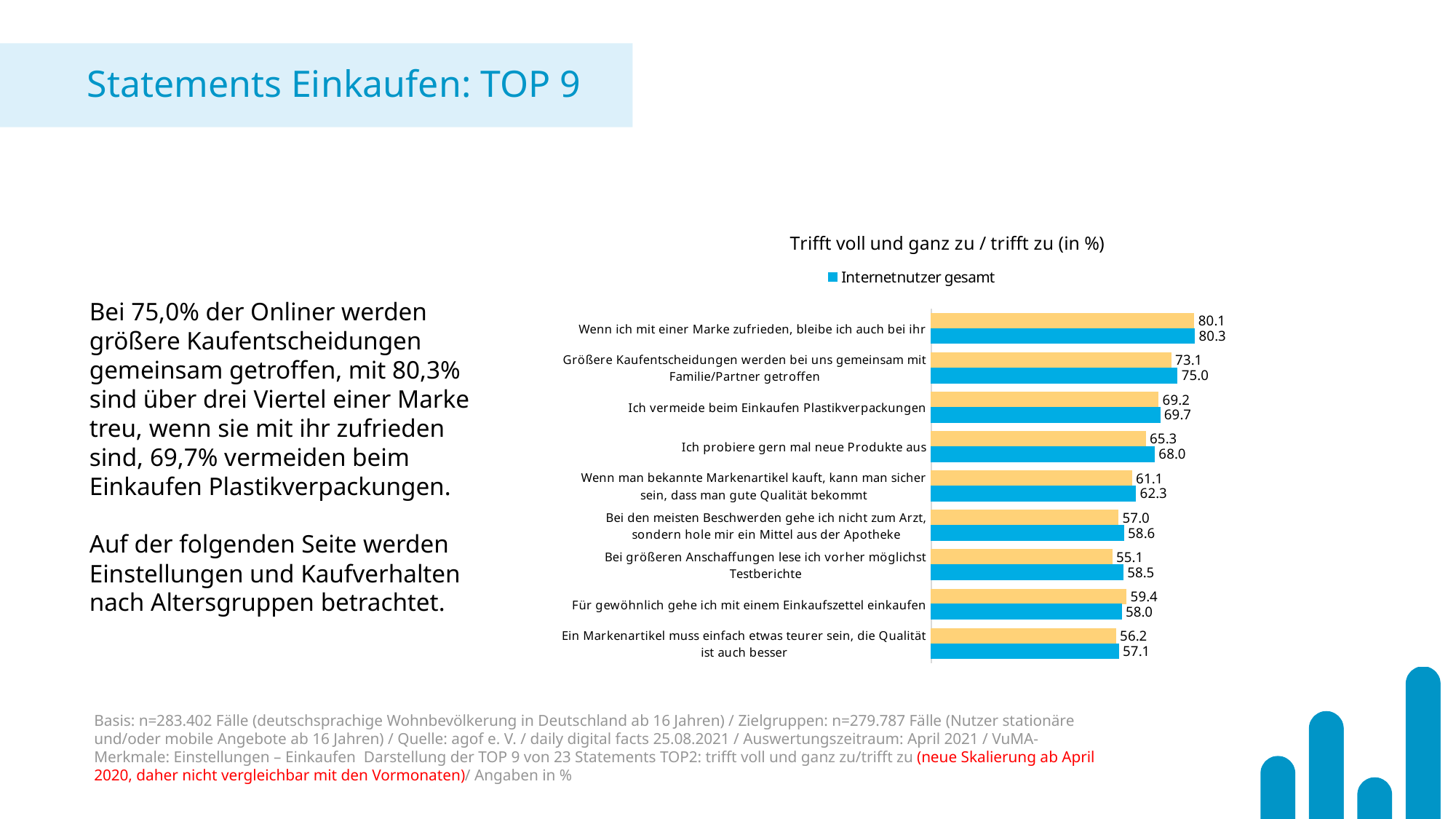
What is the value for "Internetnutzer gesamt" for the statement "Ich vermeide beim Einkaufen Plastikverpackungen"? 69.7 Which statement has the highest value for "Internetnutzer gesamt"? Wenn ich mit einer Marke zufrieden, bleibe ich auch bei ihr For "Internetnutzer gesamt", which is larger: "Ich probiere gern mal neue Produkte aus" or "Wenn man bekannte Markenartikel kauft, kann man sicher sein, dass man gute Qualität bekommt"? Ich probiere gern mal neue Produkte aus For "Internetnutzer gesamt", what is the difference between "Wenn ich mit einer Marke zufrieden, bleibe ich auch bei ihr" and "Größere Kaufentscheidungen werden bei uns gemeinsam mit Familie/Partner getroffen"? 5.3 How many statements are shown in the chart? 9 What is the value for "Internetnutzer gesamt" for the statement "Bei den meisten Beschwerden gehe ich nicht zum Arzt, sondern hole mir ein Mittel aus der Apotheke"? 58.6 For "Internetnutzer gesamt", what is the difference between "Ich vermeide beim Einkaufen Plastikverpackungen" and "Ich probiere gern mal neue Produkte aus"? 1.7 How many series does the chart legend list? 1 What kind of chart is shown on the slide? Bar chart Which statement has the lowest value for "Internetnutzer gesamt"? Ein Markenartikel muss einfach etwas teurer sein, die Qualität ist auch besser What is the title of the chart? Trifft voll und ganz zu / trifft zu (in %) What is the value for "Internetnutzer gesamt" for the statement "Für gewöhnlich gehe ich mit einem Einkaufszettel einkaufen"? 58.0